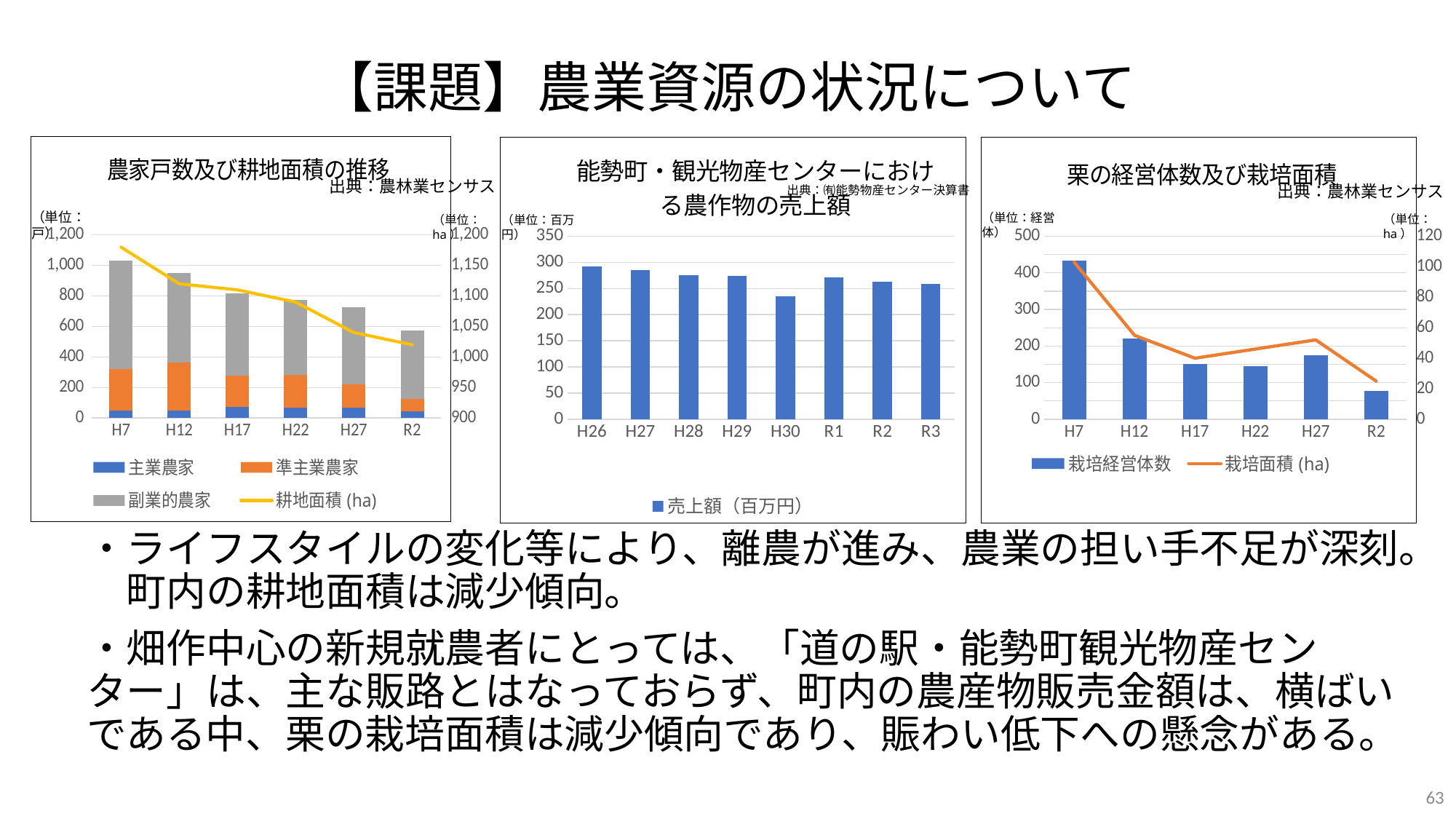
In the middle chart, 能勢町・観光物産センターにおける農作物の売上額, how many years are shown on the x axis? 8 What kind of chart is the middle chart, 能勢町・観光物産センターにおける農作物の売上額? bar chart In the chart titled 農家戸数及び耕地面積の推移, how many categories are shown on the x axis? 6 In the chart titled 栗の経営体数及び栽培面積, which is larger, the 栽培経営体数 bar for H27 or for H22? H27 In the chart titled 栗の経営体数及び栽培面積, is the 栽培経営体数 value for R2 greater or less than 100? less In the chart titled 農家戸数及び耕地面積の推移, how many series does the legend list? 4 In the middle chart, 能勢町・観光物産センターにおける農作物の売上額, is the value for H26 greater or less than 250? greater In the chart titled 農家戸数及び耕地面積の推移, does the 耕地面積 (ha) line rise or fall from H7 to R2? fall In the chart titled 栗の経営体数及び栽培面積, which category has the highest 栽培経営体数 bar? H7 In the middle chart, 能勢町・観光物産センターにおける農作物の売上額, which year has the lowest value? H30 In the chart titled 農家戸数及び耕地面積の推移, which category has the tallest stacked bar? H7 In the chart titled 農家戸数及び耕地面積の推移, is the total stacked bar for R2 greater or less than 800? less